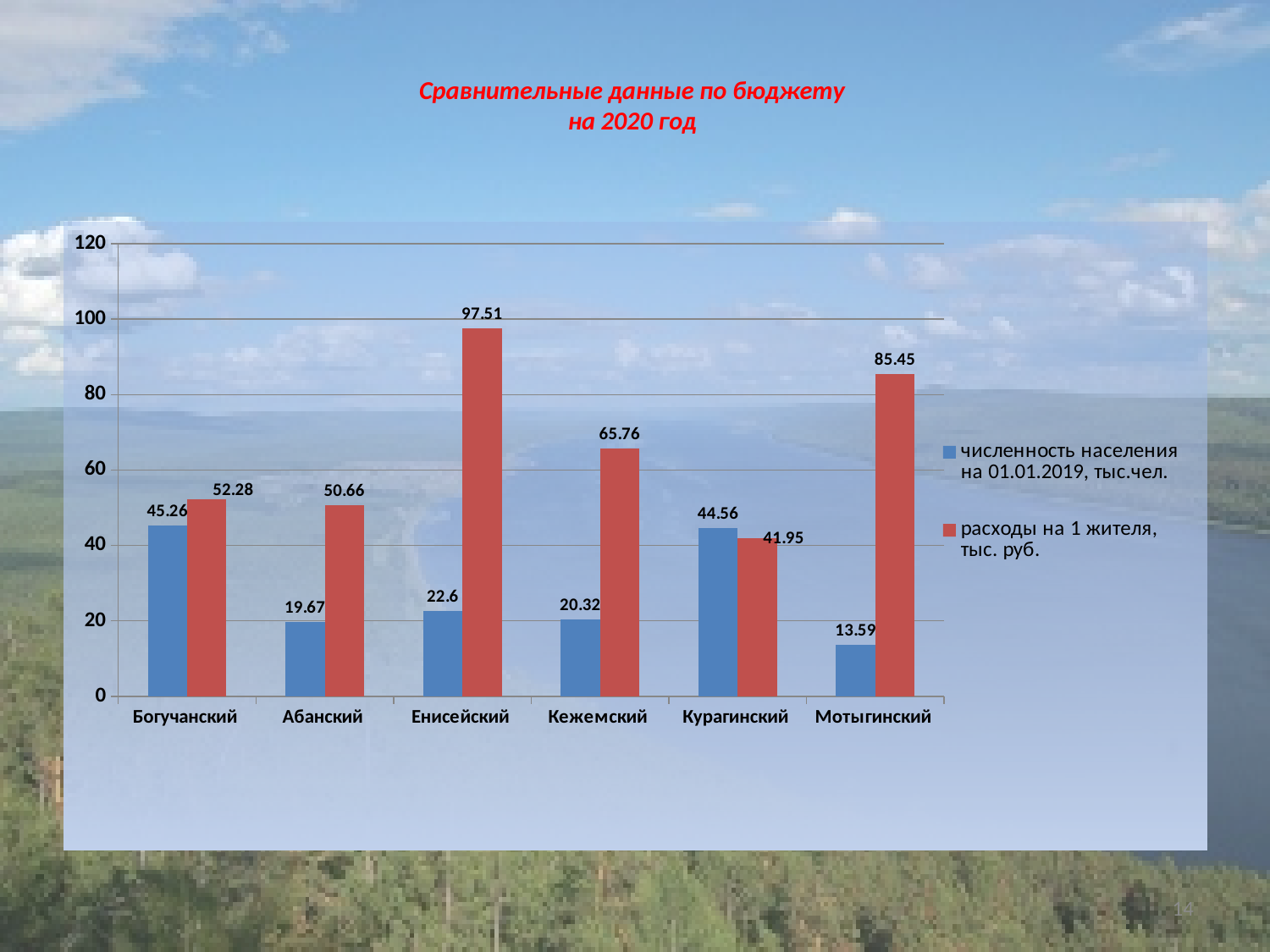
Is the value of "расходы на 1 жителя, тыс. руб." for Абанский greater or less than 40? greater How many series does the legend list? 2 How many categories are shown on the x axis? 6 Which category has the highest value for "расходы на 1 жителя, тыс. руб."? Енисейский For Курагинский, which is larger: "численность населения на 01.01.2019, тыс.чел." or "расходы на 1 жителя, тыс. руб."? численность населения на 01.01.2019, тыс.чел. What kind of chart is shown on the slide? bar chart What is the value of "расходы на 1 жителя, тыс. руб." for Енисейский? 97.51 What is the value of "численность населения на 01.01.2019, тыс.чел." for Богучанский? 45.26 Which category has the lowest value for "численность населения на 01.01.2019, тыс.чел."? Мотыгинский What is the value of "расходы на 1 жителя, тыс. руб." for Мотыгинский? 85.45 What is the difference between "расходы на 1 жителя, тыс. руб." and "численность населения на 01.01.2019, тыс.чел." for Кежемский? 45.44 Which category has the lowest value for "расходы на 1 жителя, тыс. руб."? Курагинский